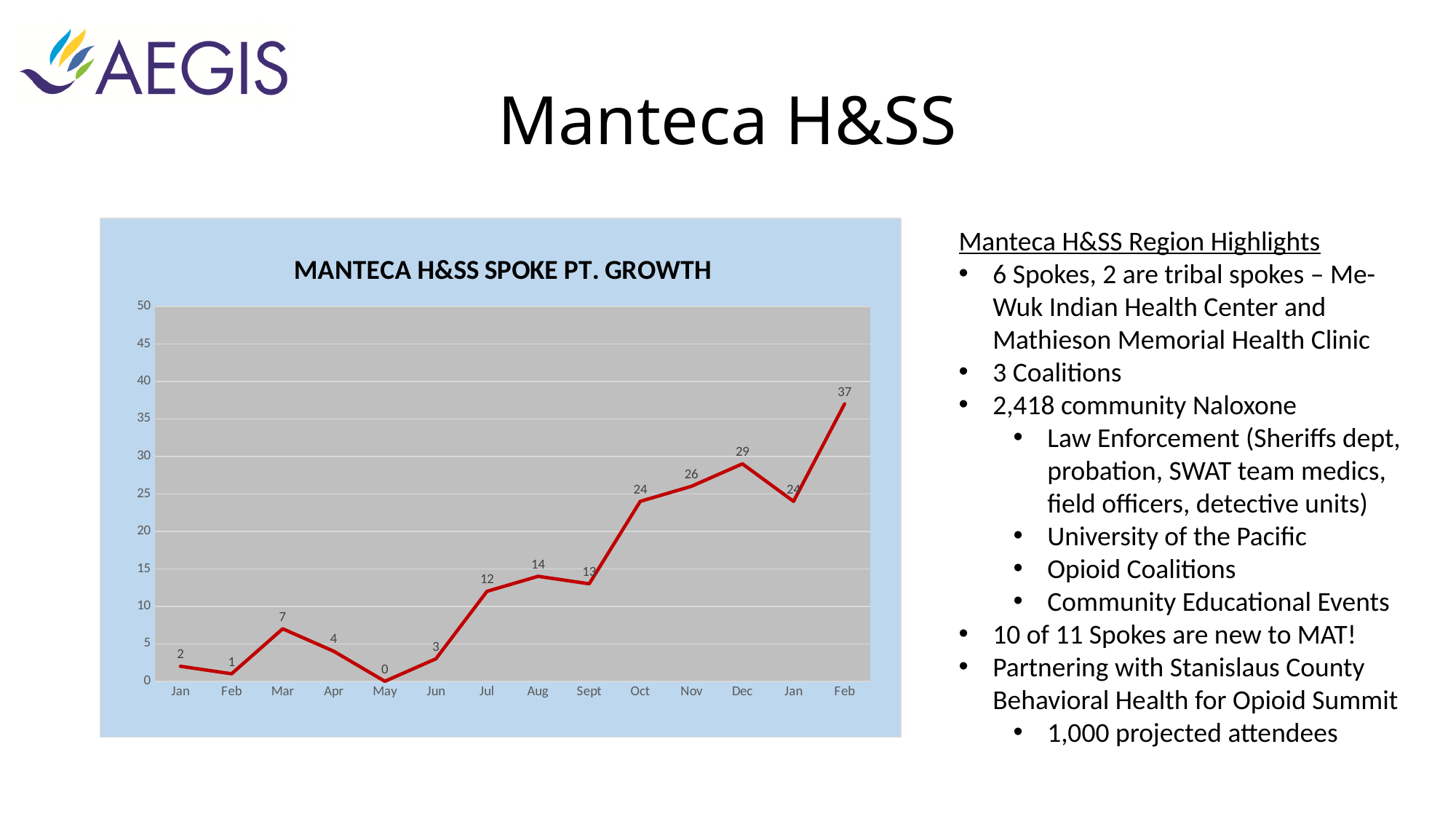
What is the value for Mar? 7 What kind of chart is shown on the slide? line chart Which month has the lowest value? May What is the title of the chart? MANTECA H&SS SPOKE PT. GROWTH Which point has the highest value? the final Feb Which is larger, the value for Aug or the value for Sept? Aug What is the value for Oct? 24 Overall, do the values rise or fall from the first Jan to the final Feb? rise What is the difference between the values for Dec and Nov? 3 How many data points are plotted on the line? 14 Is the value for Dec greater or less than 25? greater What is the value for the final Feb point at the right end of the chart? 37